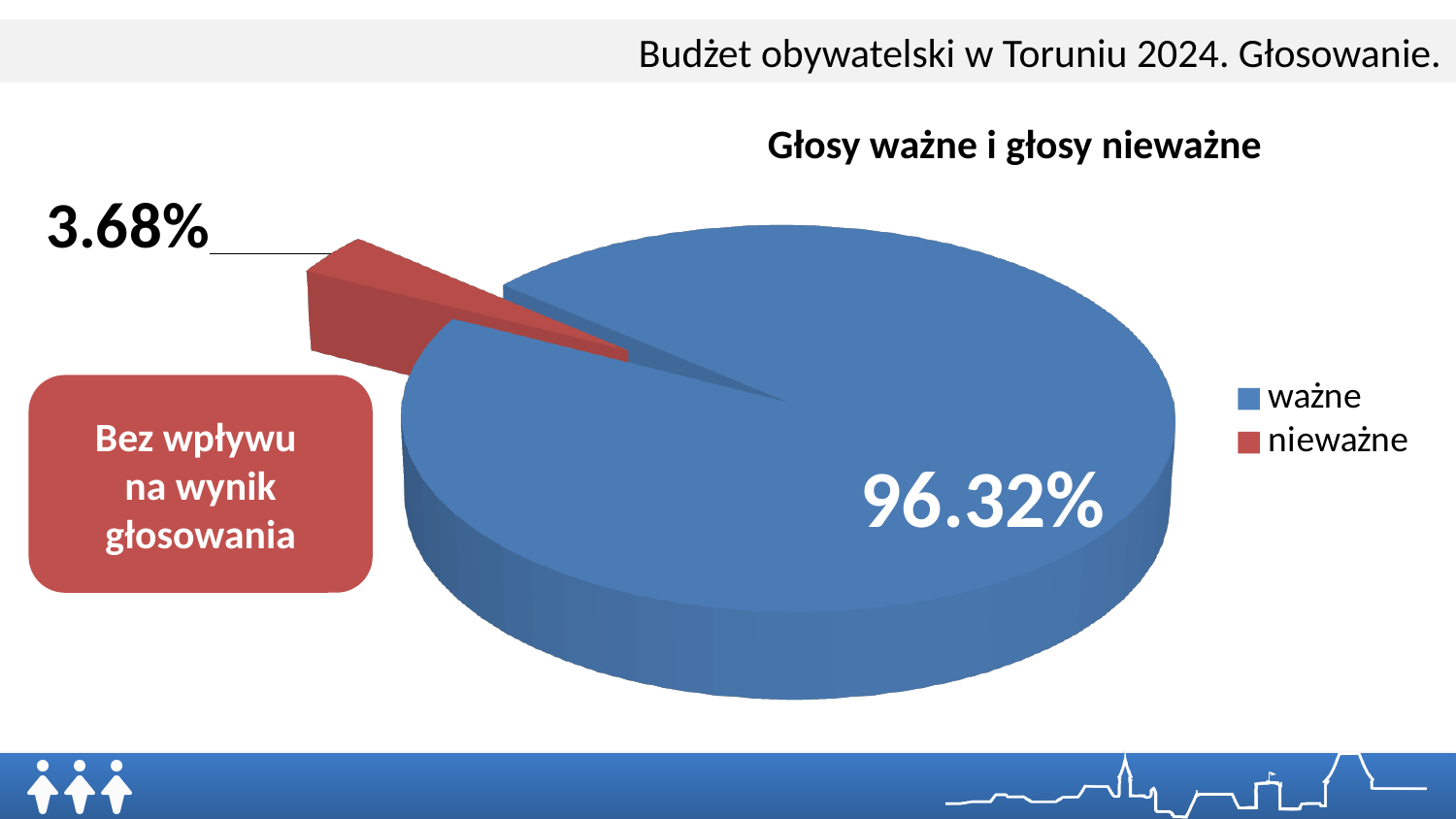
What colour is the 'nieważne' slice? red Which slice is the smallest? nieważne What share of the pie is labelled 'nieważne'? 3.68% How many entries does the legend list? 2 Which slice is the largest? ważne What is the chart's title? Głosy ważne i głosy nieważne What kind of chart is shown on the slide? pie chart Which is larger, the 'ważne' slice or the 'nieważne' slice? ważne How many slices does the pie chart have? 2 What is the difference in percentage points between the 'ważne' and 'nieważne' slices? 92.64 What share of the pie is labelled 'ważne'? 96.32%